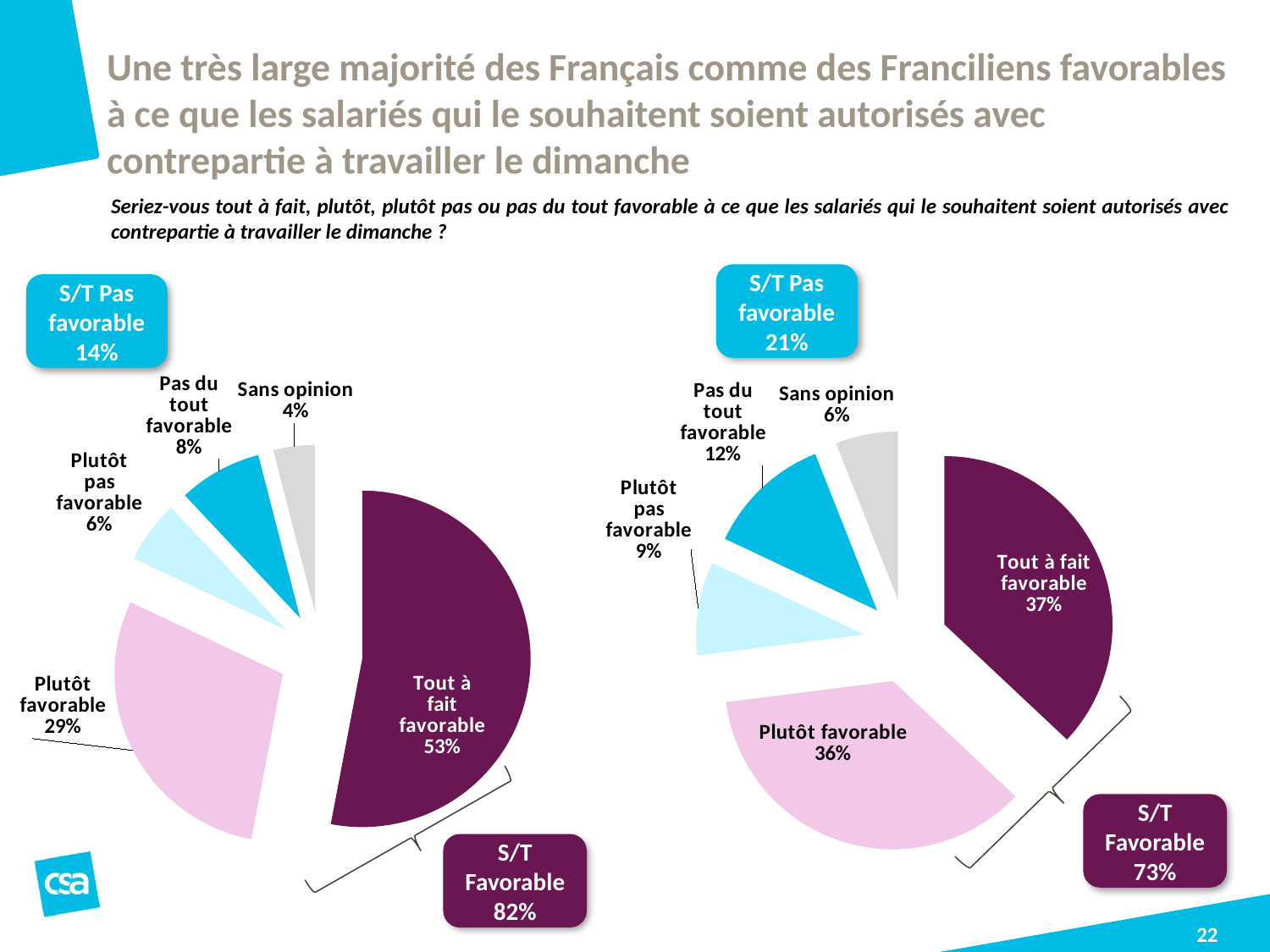
In the right pie chart, what is the difference between "Tout à fait favorable" and "Plutôt favorable"? 1 percentage point In the right pie chart, what is the value for "Sans opinion"? 6% What kind of chart is shown on the left of the slide? pie chart In the right pie chart, what is the value for "Pas du tout favorable"? 12% In the right pie chart, which category has the smallest slice? Sans opinion In the left pie chart, which category has the smallest slice? Sans opinion In the left pie chart, which category has the largest slice? Tout à fait favorable In the left pie chart, which is larger: "Pas du tout favorable" or "Plutôt pas favorable"? Pas du tout favorable What is the "S/T Favorable" value shown next to the right pie chart? 73% In the left pie chart, what is the value for "Plutôt favorable"? 29% In the left pie chart, what is the value for "Tout à fait favorable"? 53% How many slices does the right pie chart have? 5